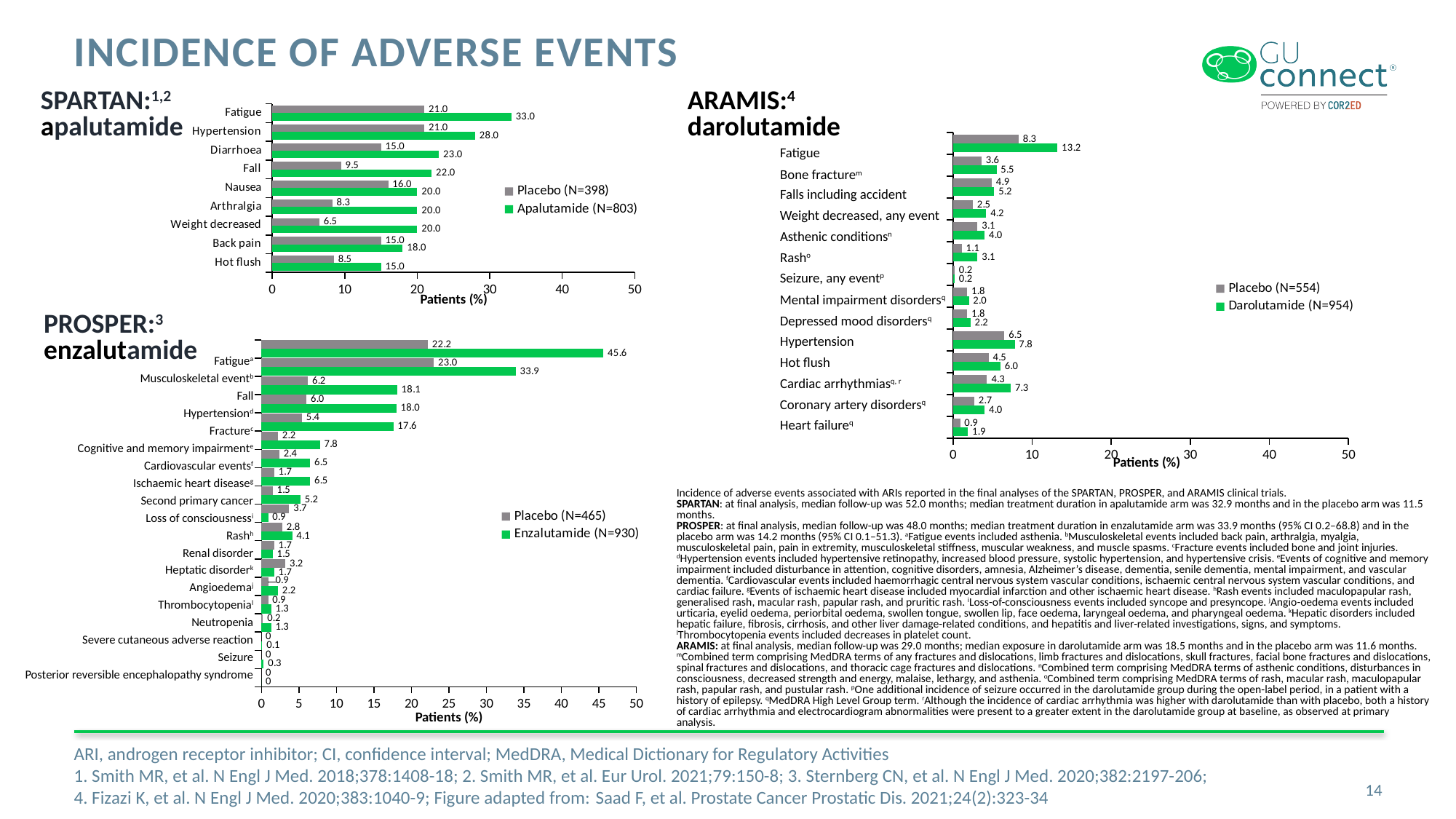
In the SPARTAN apalutamide chart, how many adverse event categories are shown? 9 In the SPARTAN apalutamide chart, what is the value for Fatigue in the Apalutamide (N=803) series? 33.0 In the ARAMIS darolutamide chart, how many series does the legend list? 2 In the PROSPER enzalutamide chart, what is the Enzalutamide (N=930) value for Fatigue? 45.6 In the PROSPER enzalutamide chart, what is the Placebo (N=465) value for Hepatic disorder? 3.2 In the SPARTAN apalutamide chart, what is the difference between the Apalutamide and Placebo values for Weight decreased? 13.5 What type of chart is used for the ARAMIS darolutamide data? Bar chart In the PROSPER enzalutamide chart, which adverse event has the highest Enzalutamide (N=930) value? Fatigue In the ARAMIS darolutamide chart, what is the Darolutamide (N=954) value for Cardiac arrhythmias? 7.3 In the SPARTAN apalutamide chart, what is the Placebo (N=398) value for Fall? 9.5 In the ARAMIS darolutamide chart, which adverse event has the highest Darolutamide (N=954) value? Fatigue In the PROSPER enzalutamide chart, which is larger for Loss of consciousness: the Placebo value or the Enzalutamide value? Placebo